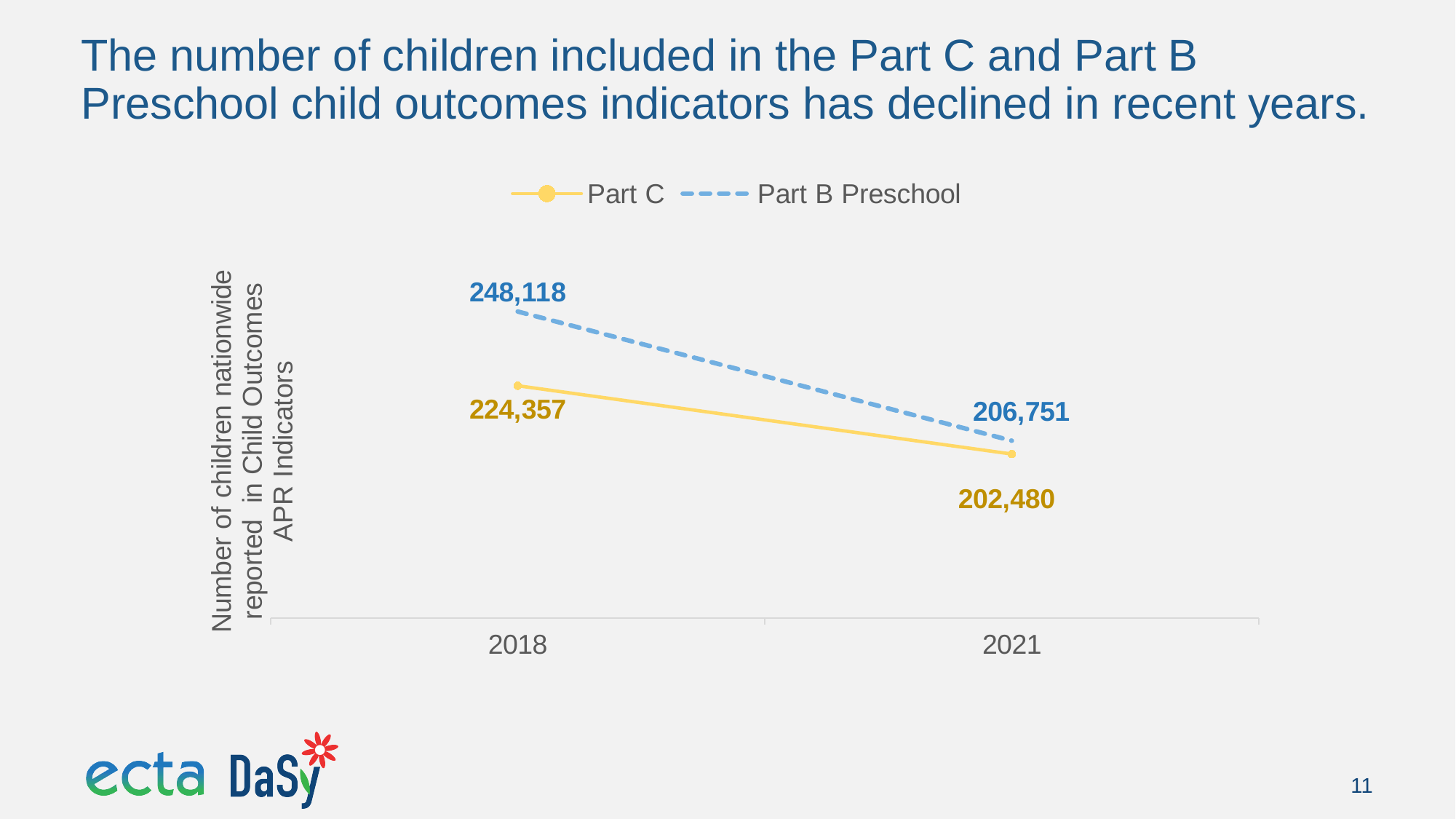
What is the value for Part C in 2021? 202,480 What is the value for Part B Preschool in 2021? 206,751 How many series does the legend list? 2 What kind of chart is shown on the slide? line chart What is the difference between the Part B Preschool and Part C values in 2021? 4,271 By how much did the Part C value decline from 2018 to 2021? 21,877 By how much did the Part B Preschool value decline from 2018 to 2021? 41,367 What is the value for Part C in 2018? 224,357 Which series has the higher value in 2018? Part B Preschool Does the Part C series rise or fall from 2018 to 2021? fall How many years are shown on the x axis? 2 What is the value for Part B Preschool in 2018? 248,118